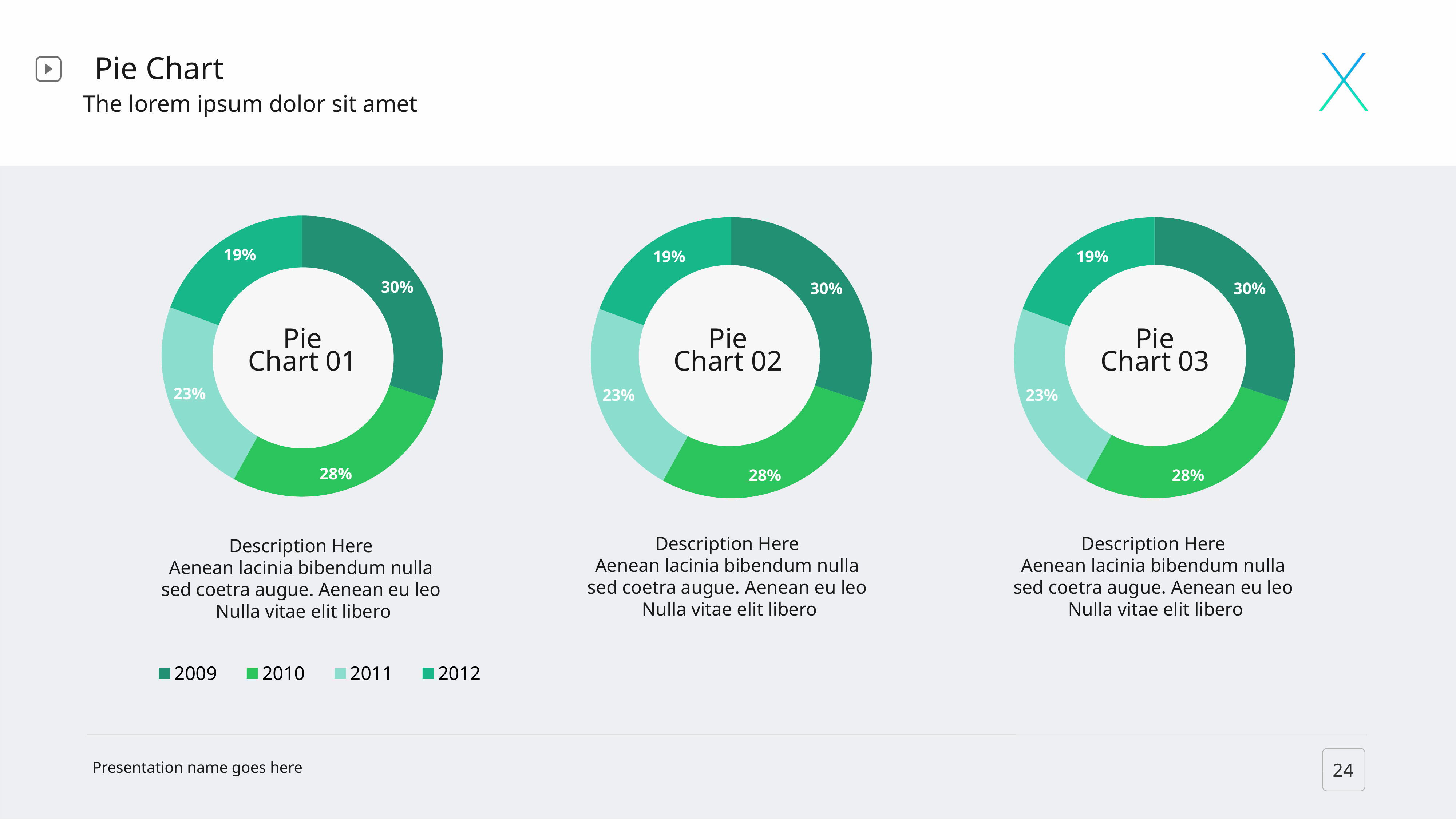
Which year does the lightest green colour represent in the legend? 2011 In Pie Chart 01, which is larger, the 2010 slice or the 2011 slice? 2010 In Pie Chart 02, what is the value for 2011? 23% In Pie Chart 03, what is the difference between the 2009 and 2012 slices? 11% In Pie Chart 01, which year has the largest slice? 2009 How many slices does Pie Chart 02 have? 4 How many entries does the legend list? 4 In Pie Chart 02, what is the combined share of the 2009 and 2010 slices? 58% What kind of chart is Pie Chart 03? Pie chart In Pie Chart 02, which year has the smallest slice? 2012 In Pie Chart 03, what is the value for 2012? 19% In Pie Chart 01, what is the value for 2009? 30%